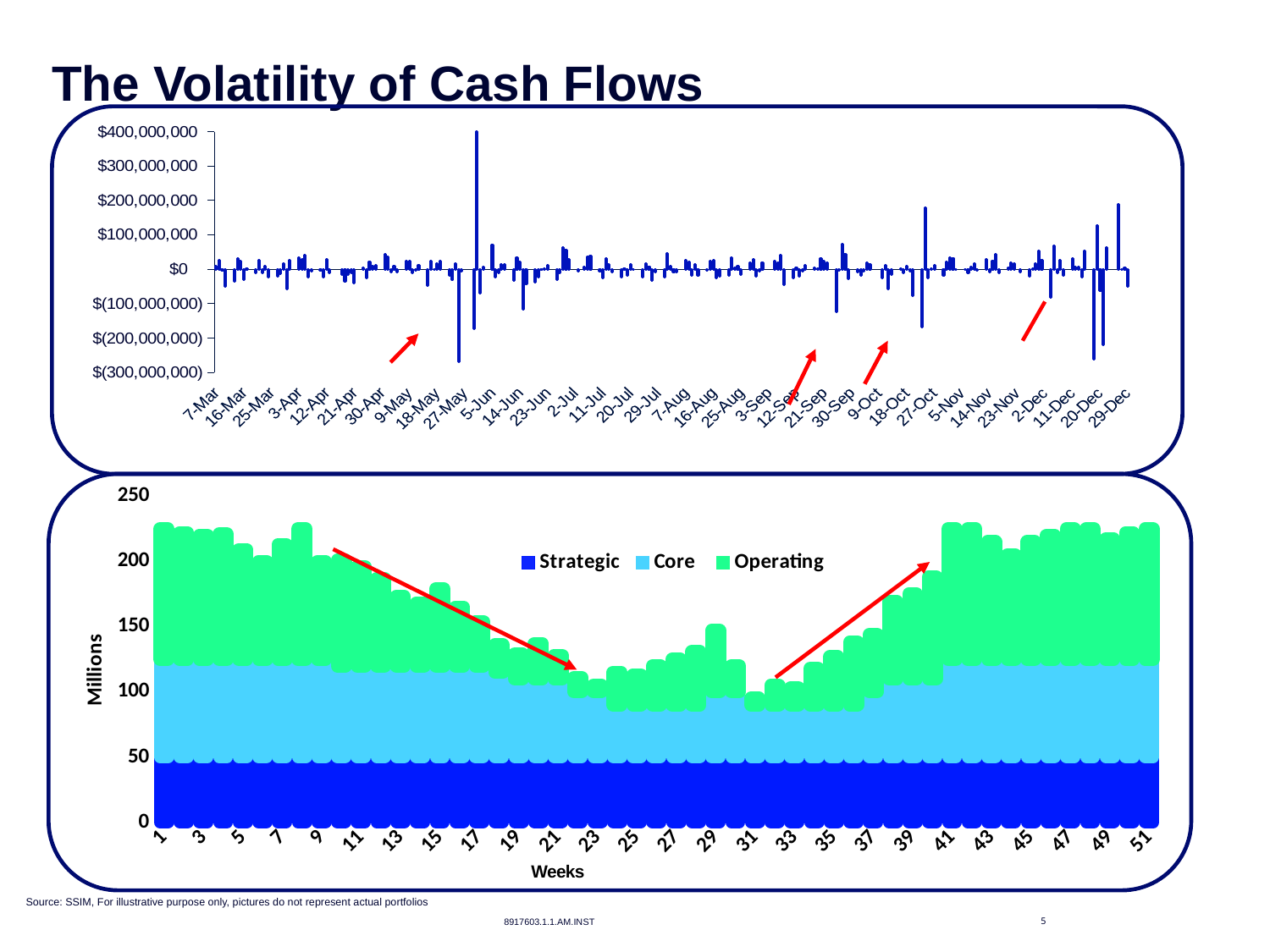
What is the x-axis title of the bottom chart? Weeks In the bottom chart, do the total stacked values rise or fall from week 31 to week 41? rise In the top chart, is the lowest negative bar (near 27-May) greater or less than $(200,000,000)? less In the bottom chart, is the total stacked value for week 1 larger or smaller than the total for week 31? larger In the top chart, is the tallest positive bar (near the end of May) greater or less than $300,000,000? greater In the bottom chart, is the total stacked value for week 1 greater or less than 200? greater In the bottom chart, do the total stacked values rise or fall from week 9 to week 23? fall What are the three series named in the legend of the bottom chart? Strategic, Core, Operating What kind of chart is the bottom chart (Weeks on the x axis)? Stacked bar chart How many series does the legend of the bottom chart list? 3